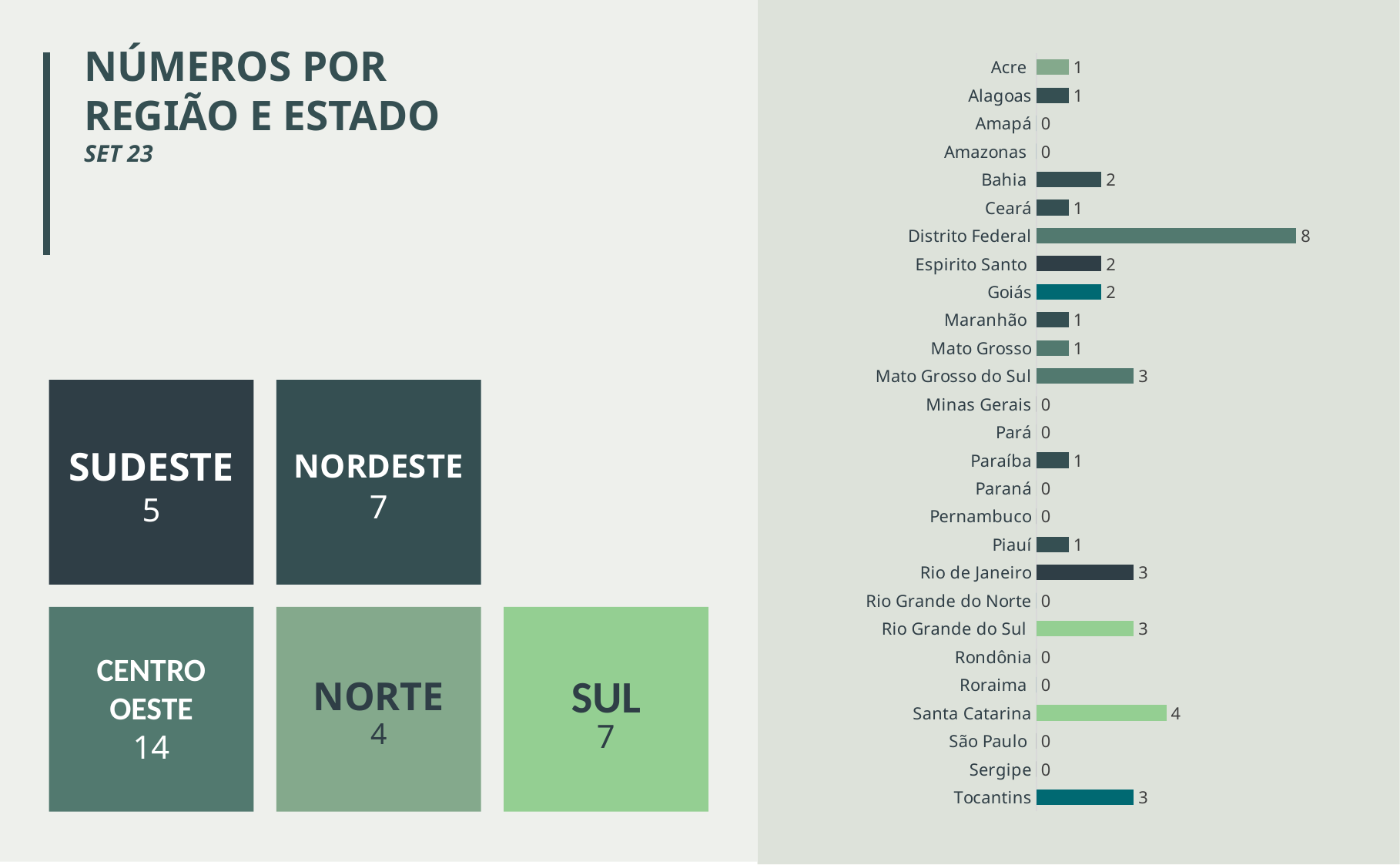
In the bar chart on the right, what is the value for Mato Grosso do Sul? 3 In the bar chart on the right, how many states have a value of 0? 11 In the bar chart on the right, what is the value for Distrito Federal? 8 In the bar chart on the right, what is the value for Santa Catarina? 4 In the bar chart on the right, which state has the highest value? Distrito Federal In the bar chart on the right, what is the difference between the values for Distrito Federal and Santa Catarina? 4 In the bar chart on the right, what is the value for Bahia? 2 How many states are listed in the bar chart on the right? 27 In the bar chart on the right, which has a larger value, Rio de Janeiro or Goiás? Rio de Janeiro What kind of chart is shown on the right side of the slide? Bar chart In the bar chart on the right, which has a larger value, Tocantins or Piauí? Tocantins What is the title of the slide? NÚMEROS POR REGIÃO E ESTADO